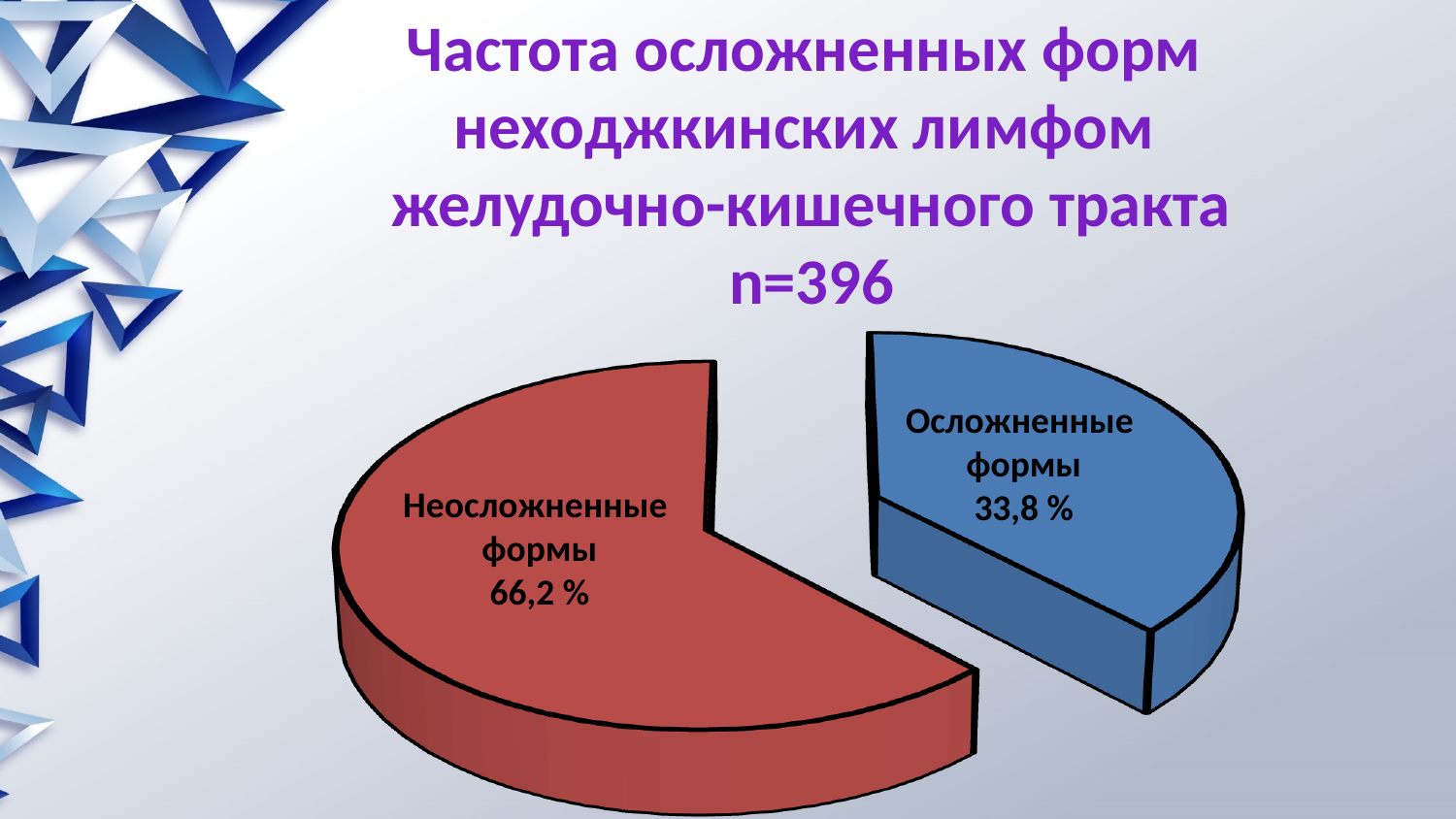
What is the sample size (n) stated in the chart title? n=396 Which is larger: the share for 'Осложненные формы' or the share for 'Неосложненные формы'? Неосложненные формы Which slice of the pie is the largest? Неосложненные формы What is the difference in percentage points between 'Неосложненные формы' and 'Осложненные формы'? 32,4 % How many slices does the pie chart have? 2 What share of the pie is labelled 'Неосложненные формы'? 66,2 % What colour is the slice for 'Осложненные формы'? blue What kind of chart is shown on the slide? pie chart Which slice of the pie is the smallest? Осложненные формы What share of the pie is labelled 'Осложненные формы'? 33,8 %